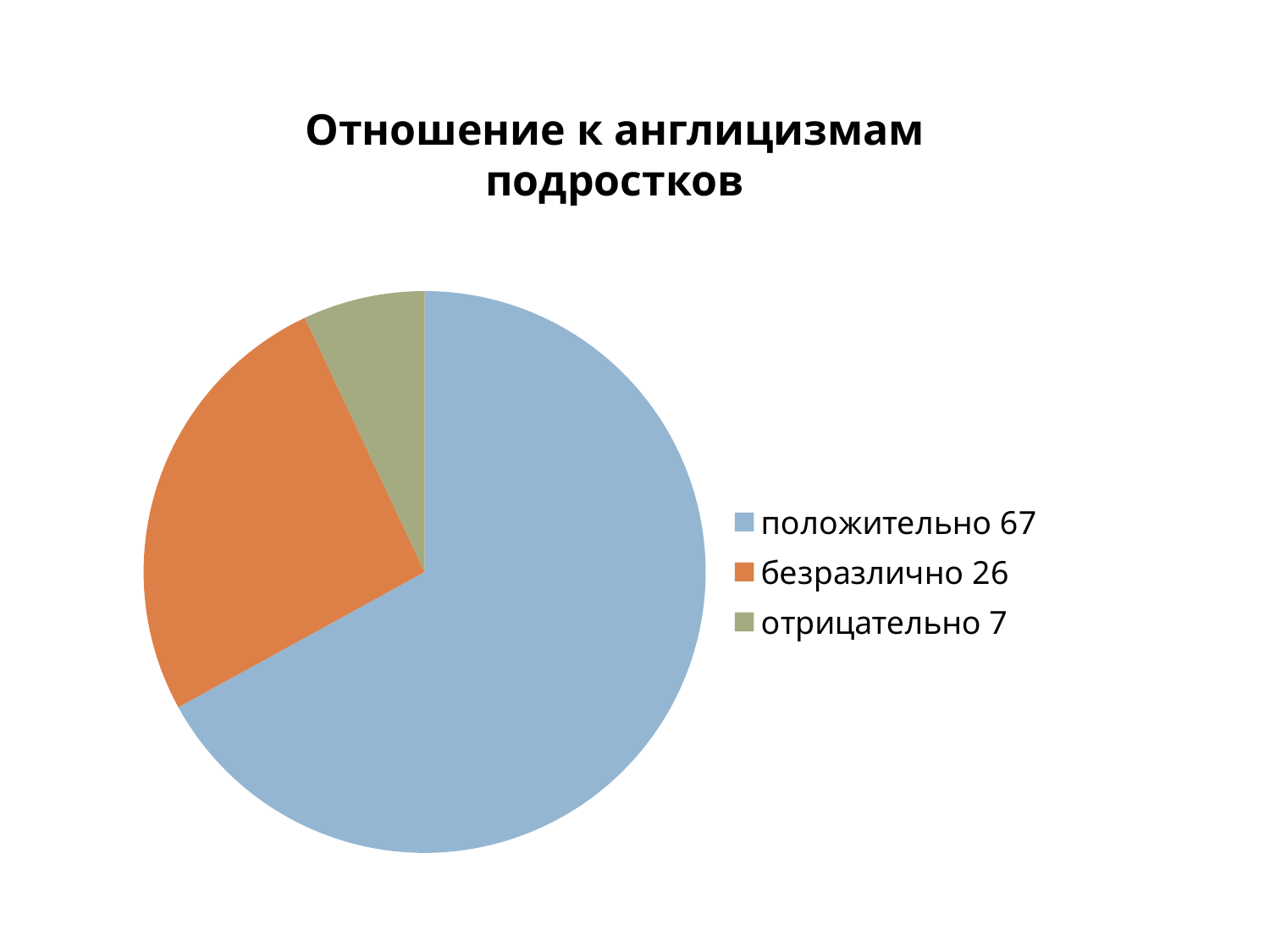
What kind of chart is shown on the slide? pie chart Which category has the largest slice? положительно What is the value for "положительно"? 67 What colour is the slice for "безразлично"? orange What is the title of the chart? Отношение к англицизмам подростков Which is larger, the value for "безразлично" or the value for "отрицательно"? безразлично What is the difference between the values for "положительно" and "безразлично"? 41 What is the value for "безразлично"? 26 What is the total of all three values in the pie chart? 100 What is the value for "отрицательно"? 7 Which category has the smallest slice? отрицательно How many categories does the pie chart have? 3